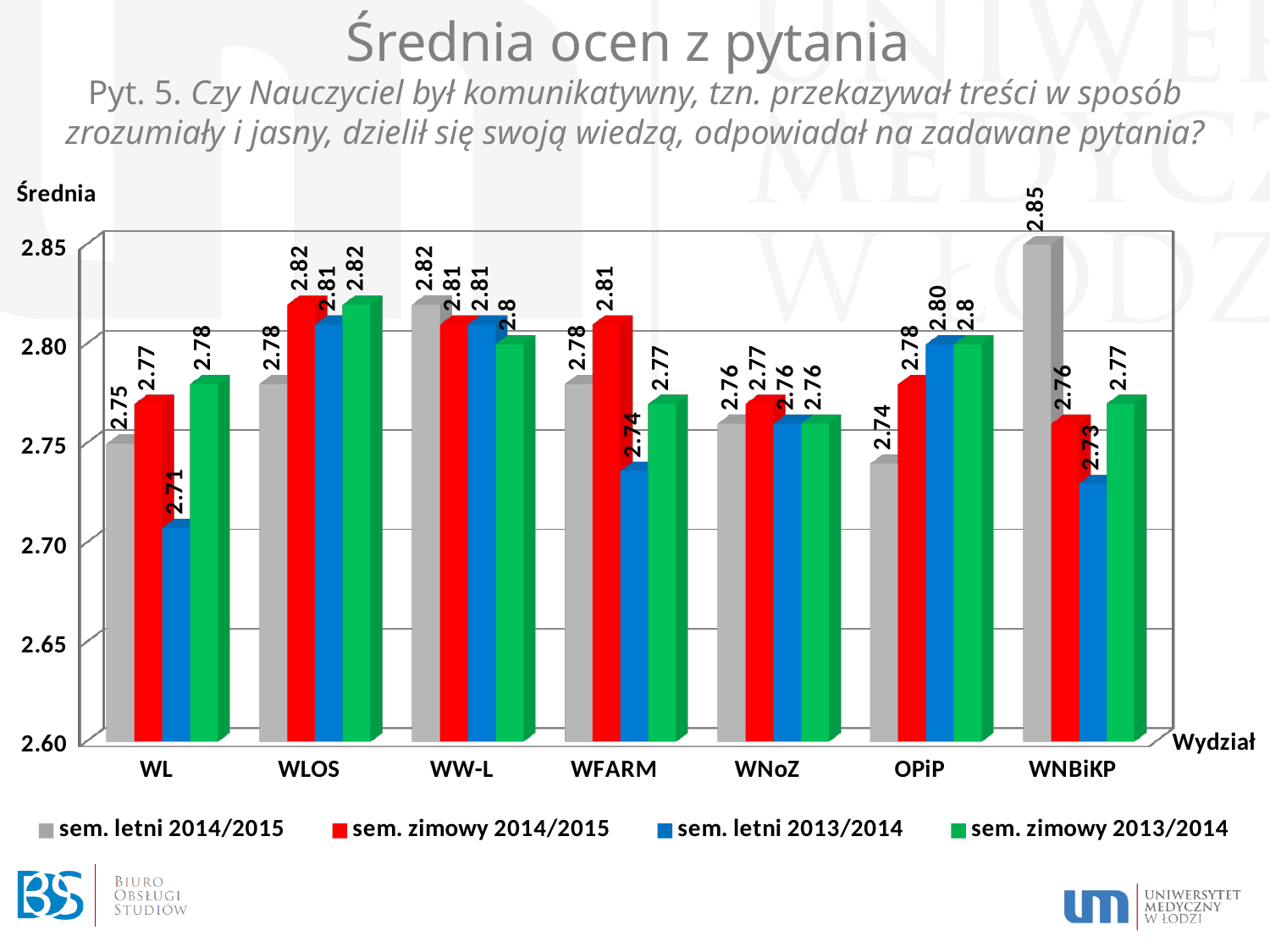
What is the label of the vertical axis? Średnia How many series does the legend list? 4 Which is larger for WFARM: sem. zimowy 2014/2015 or sem. letni 2013/2014? sem. zimowy 2014/2015 What is the value for WL in sem. letni 2013/2014? 2.71 Which faculty has the lowest value in sem. letni 2013/2014? WL What type of chart is shown on the slide? bar chart How many faculties (Wydział) are shown on the x axis? 7 What is the value for OPiP in sem. zimowy 2014/2015? 2.78 What is the difference between the sem. letni 2014/2015 and sem. letni 2013/2014 values for WNBiKP? 0.12 Which faculty has the highest value in sem. letni 2014/2015? WNBiKP What is the value for WNBiKP in sem. letni 2014/2015? 2.85 Is the value for WL in sem. letni 2013/2014 greater or less than 2.75? less